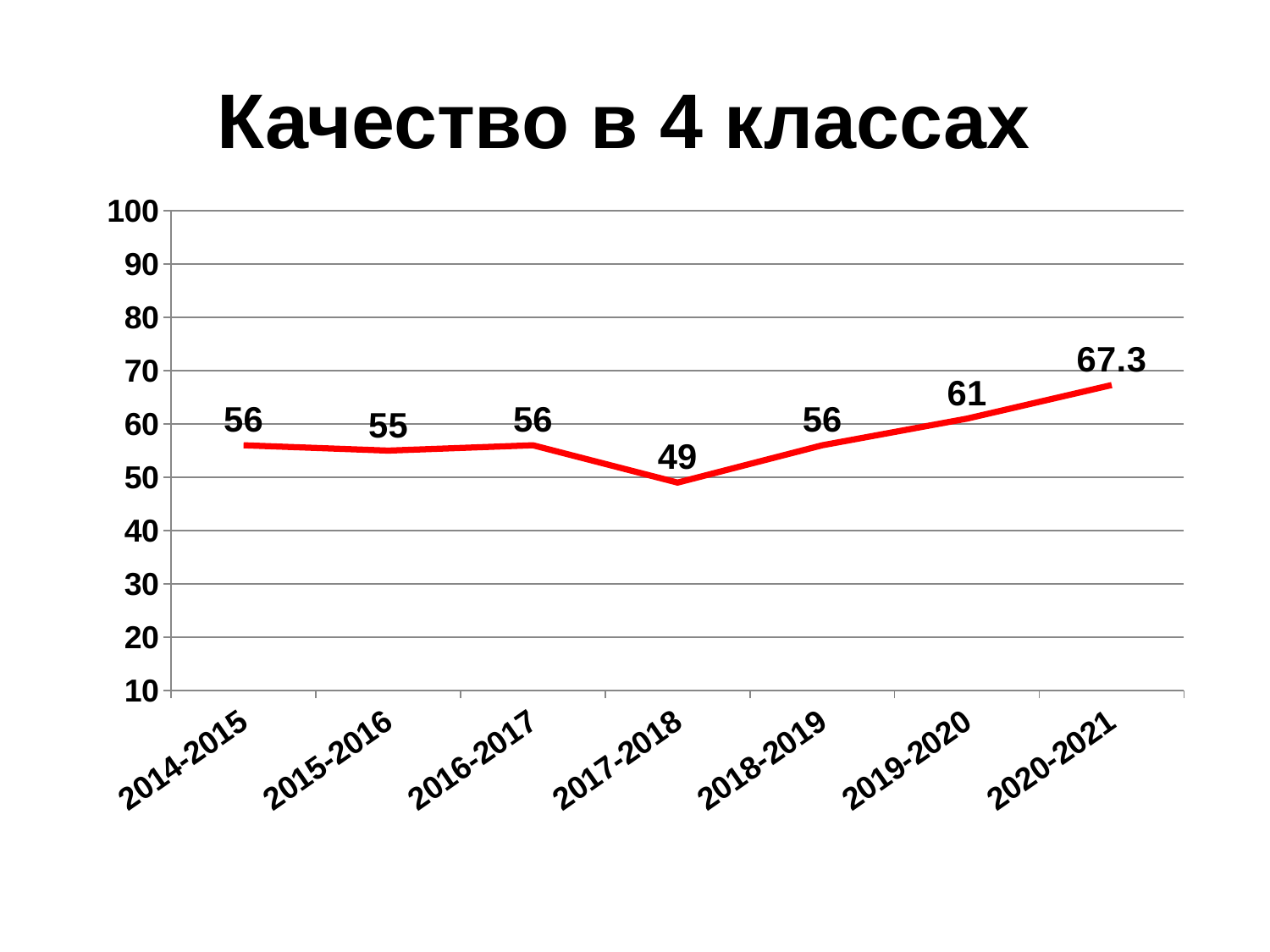
Is the value for 2020-2021 greater or less than 60? greater What is the value for 2017-2018? 49 What is the value for 2019-2020? 61 What kind of chart is this? line chart Which year has the highest value? 2020-2021 How many years are shown on the x axis? 7 What is the difference between the values for 2019-2020 and 2018-2019? 5 What is the value for 2020-2021? 67.3 Which year has the lowest value? 2017-2018 Do the values rise or fall from 2017-2018 to 2020-2021? rise Which is larger, the value for 2015-2016 or the value for 2019-2020? 2019-2020 What is the difference between the values for 2020-2021 and 2017-2018? 18.3